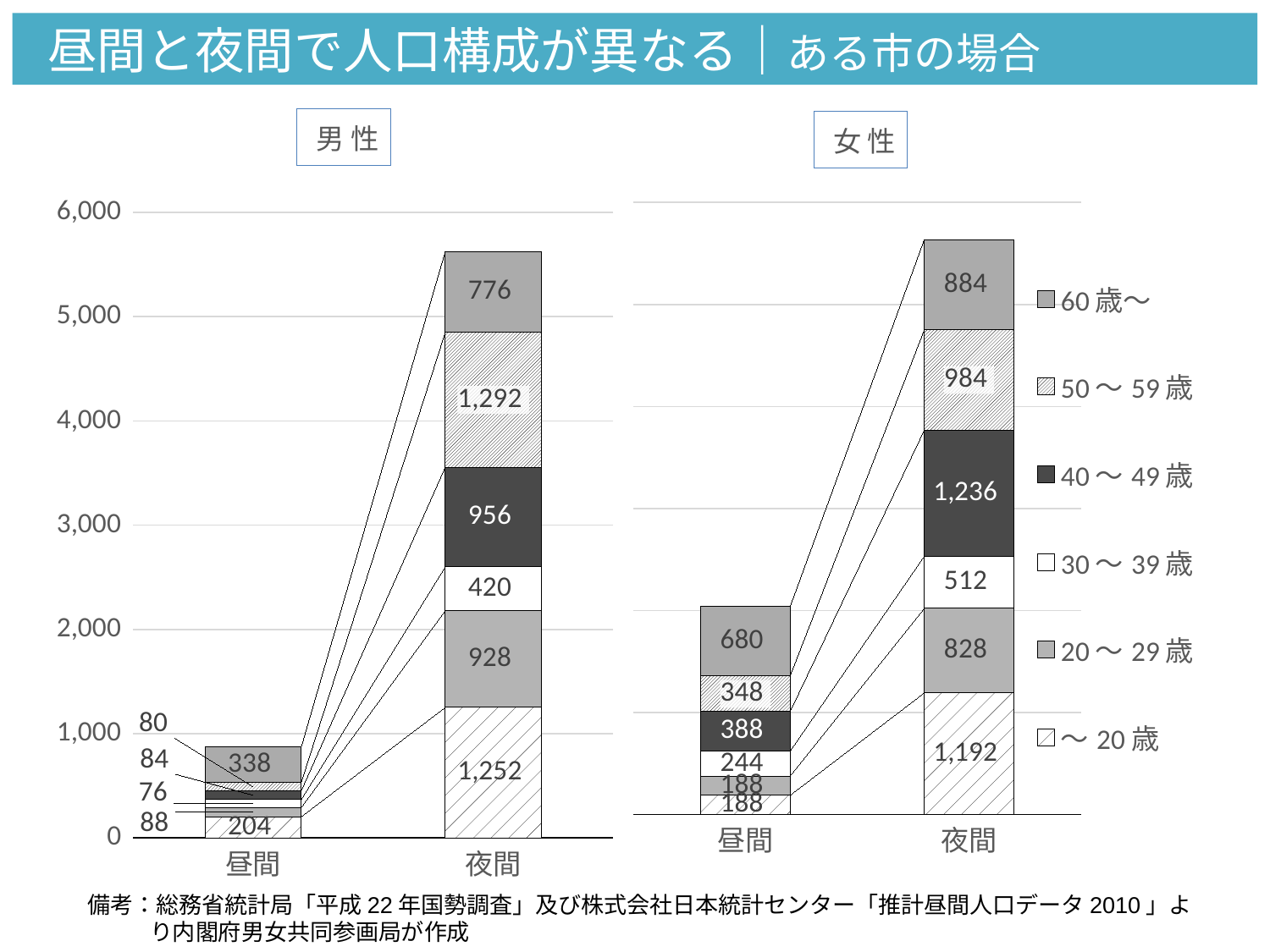
In the 女性 chart, which segment of the 夜間 bar is the largest? 40～49歳 In the 男性 chart, what is the difference between the ～20歳 segment for 夜間 and the ～20歳 segment for 昼間? 1,048 In the 女性 chart, what is the total of the stacked bar for 昼間? 2,036 In the 男性 chart, what is the total of the stacked bar for 夜間? 5,624 In the 女性 chart, what is the value of the 40～49歳 segment for 夜間? 1,236 In the 女性 chart, what is the value of the 60歳～ segment for 昼間? 680 In the 女性 chart, is the 60歳～ segment for 夜間 larger or smaller than the 50～59歳 segment for 夜間? smaller In the 男性 chart, what is the value of the ～20歳 segment for 昼間? 204 In the 男性 chart, what is the value of the 50～59歳 segment for 夜間? 1,292 How many series does the legend list? 6 In the 男性 chart, is the total for 昼間 greater or less than 1,000? less What kind of chart is used for 男性 and 女性? stacked bar chart